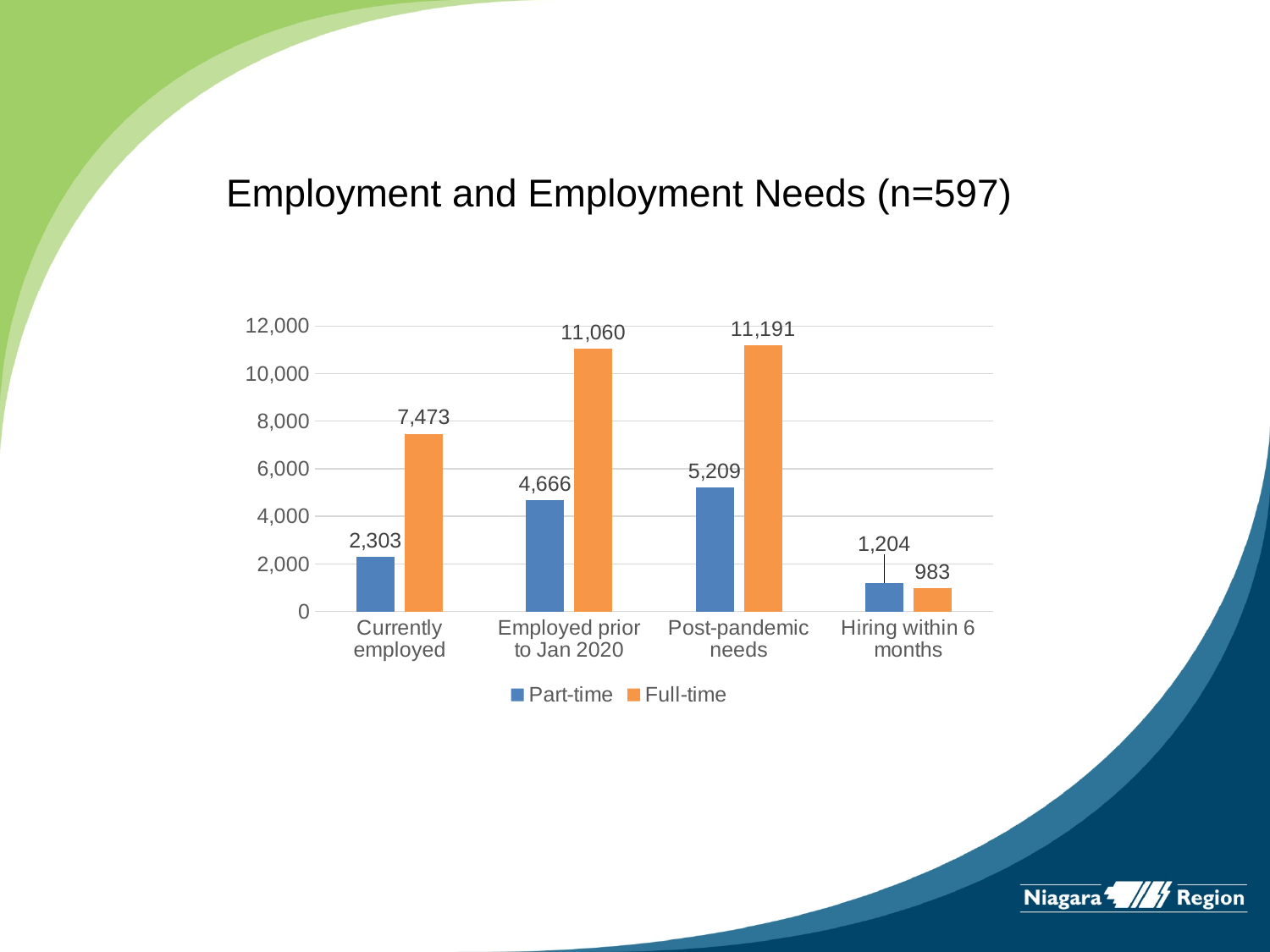
What is the Part-time value for Currently employed? 2,303 Is the Full-time value for Currently employed greater or less than 6,000? greater What is the Full-time value for Hiring within 6 months? 983 What kind of chart is shown on the slide? Bar chart What is the title of the chart? Employment and Employment Needs (n=597) What is the Full-time value for Post-pandemic needs? 11,191 How many series does the legend list? 2 For Hiring within 6 months, which is larger: Part-time or Full-time? Part-time What is the difference between the Full-time and Part-time values for Employed prior to Jan 2020? 6,394 Which category has the lowest Part-time value? Hiring within 6 months How many categories are shown on the x axis? 4 Which category has the highest Full-time value? Post-pandemic needs